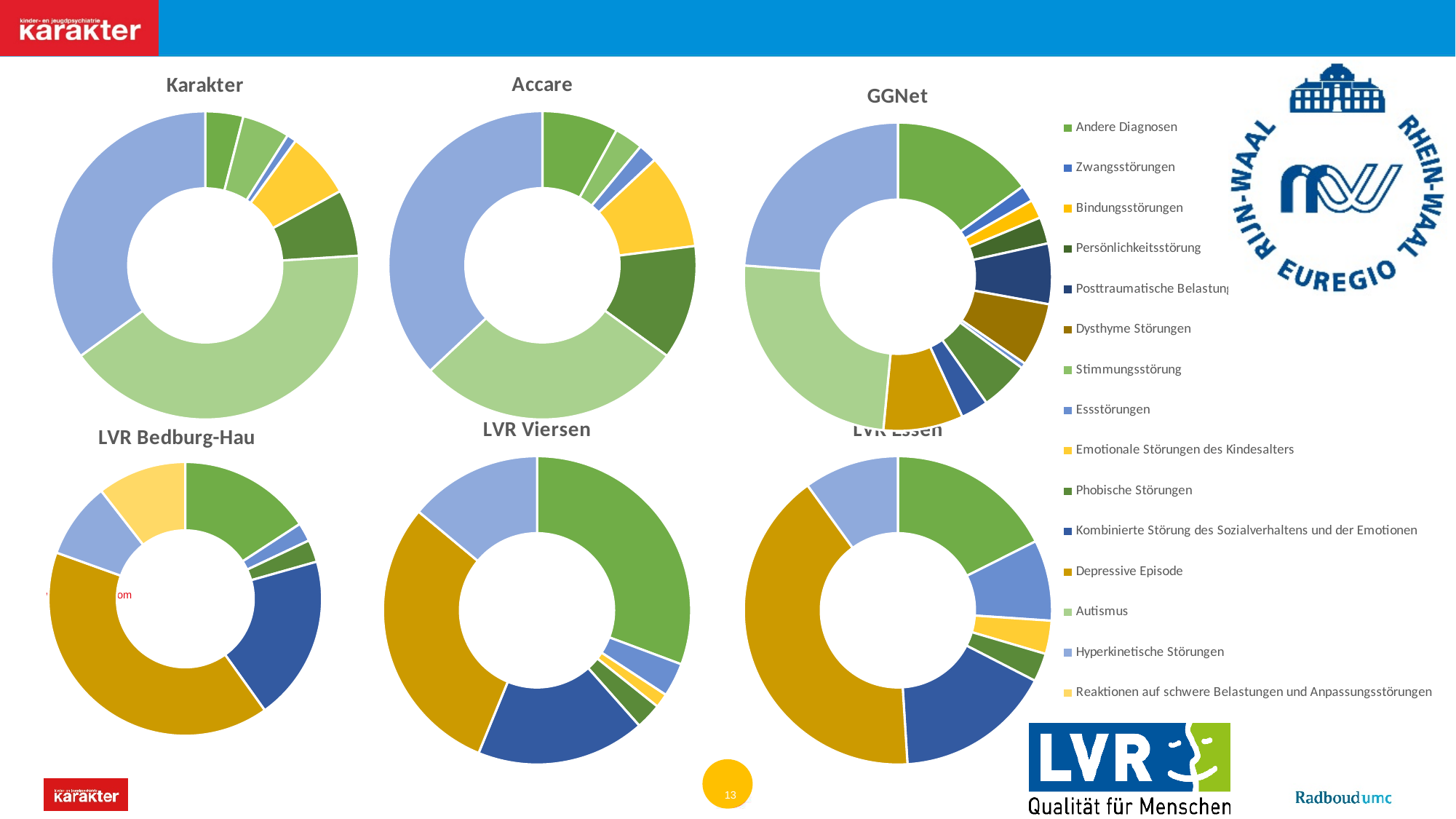
In the LVR Essen chart, which is larger: the Depressive Episode slice or the Hyperkinetische Störungen slice? Depressive Episode In the LVR Bedburg-Hau chart, which category has the largest slice? Depressive Episode In the GGNet chart, which is larger: the Essstörungen slice or the Bindungsstörungen slice? Bindungsstörungen What kind of chart is used for the six charts on this slide? Pie (donut) chart What is the title of the chart in the top-left position? Karakter In the LVR Essen chart, which category has the largest slice? Depressive Episode In the LVR Bedburg-Hau chart, which is larger: the Depressive Episode slice or the Reaktionen auf schwere Belastungen und Anpassungsstörungen slice? Depressive Episode What is the title of the chart in the bottom-middle position? LVR Viersen How many charts are shown on the slide? 6 How many categories does the legend list? 15